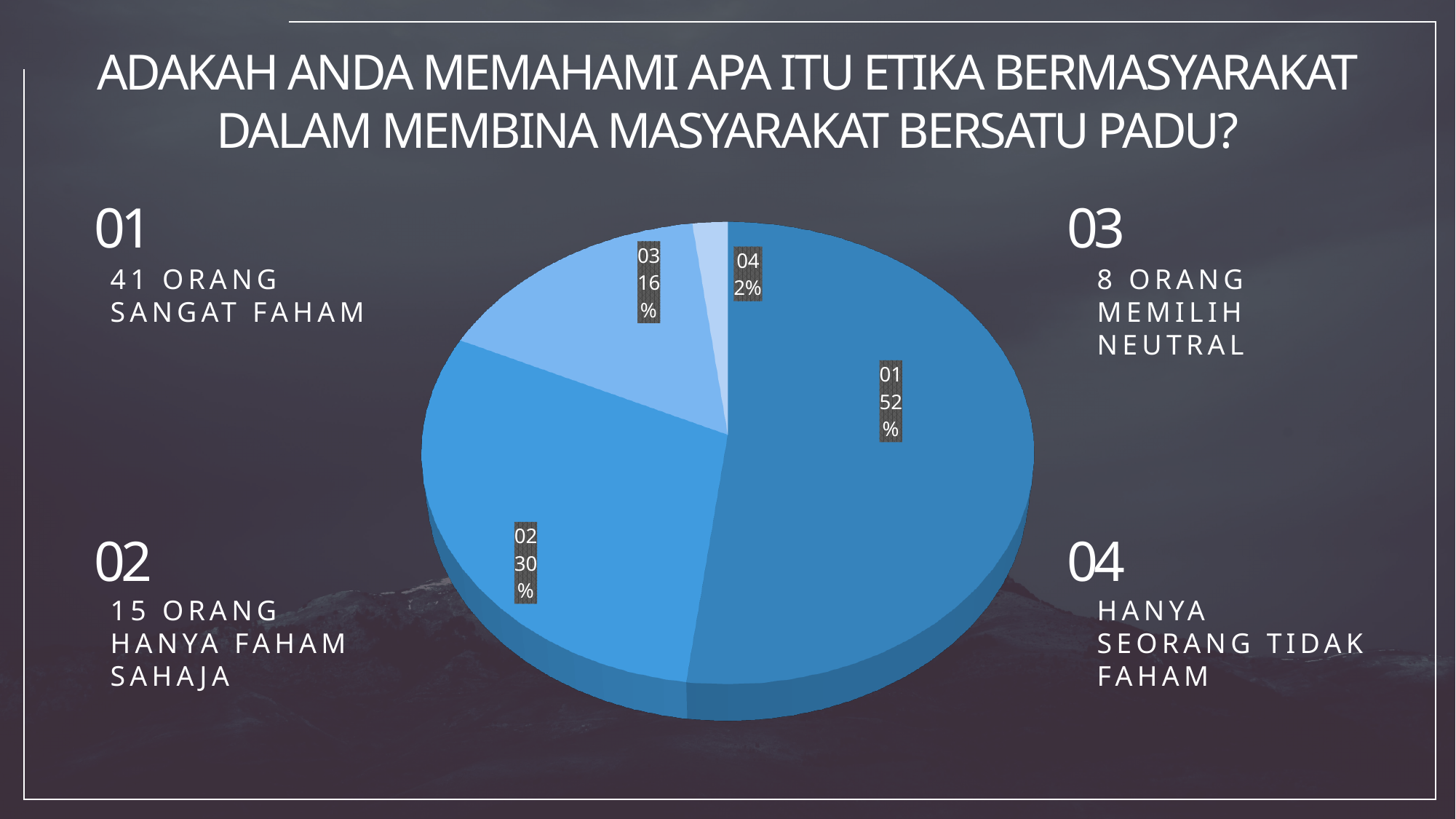
What percentage is shown for slice 01 in the pie chart? 52% Which is larger in the pie chart, slice 02 or slice 03? 02 How many slices does the pie chart have? 4 What percentage is shown for slice 03 in the pie chart? 16% What percentage is shown for slice 04 in the pie chart? 2% Which slice of the pie chart is the largest? 01 What is the combined share of slices 03 and 04 in the pie chart? 18% What percentage is shown for slice 02 in the pie chart? 30% Which slice of the pie chart is the smallest? 04 What is the difference in percentage points between slice 01 and slice 02 in the pie chart? 22 According to the slide text, how many people chose 'sangat faham' (slice 01)? 41 orang What kind of chart is shown on the slide? pie chart